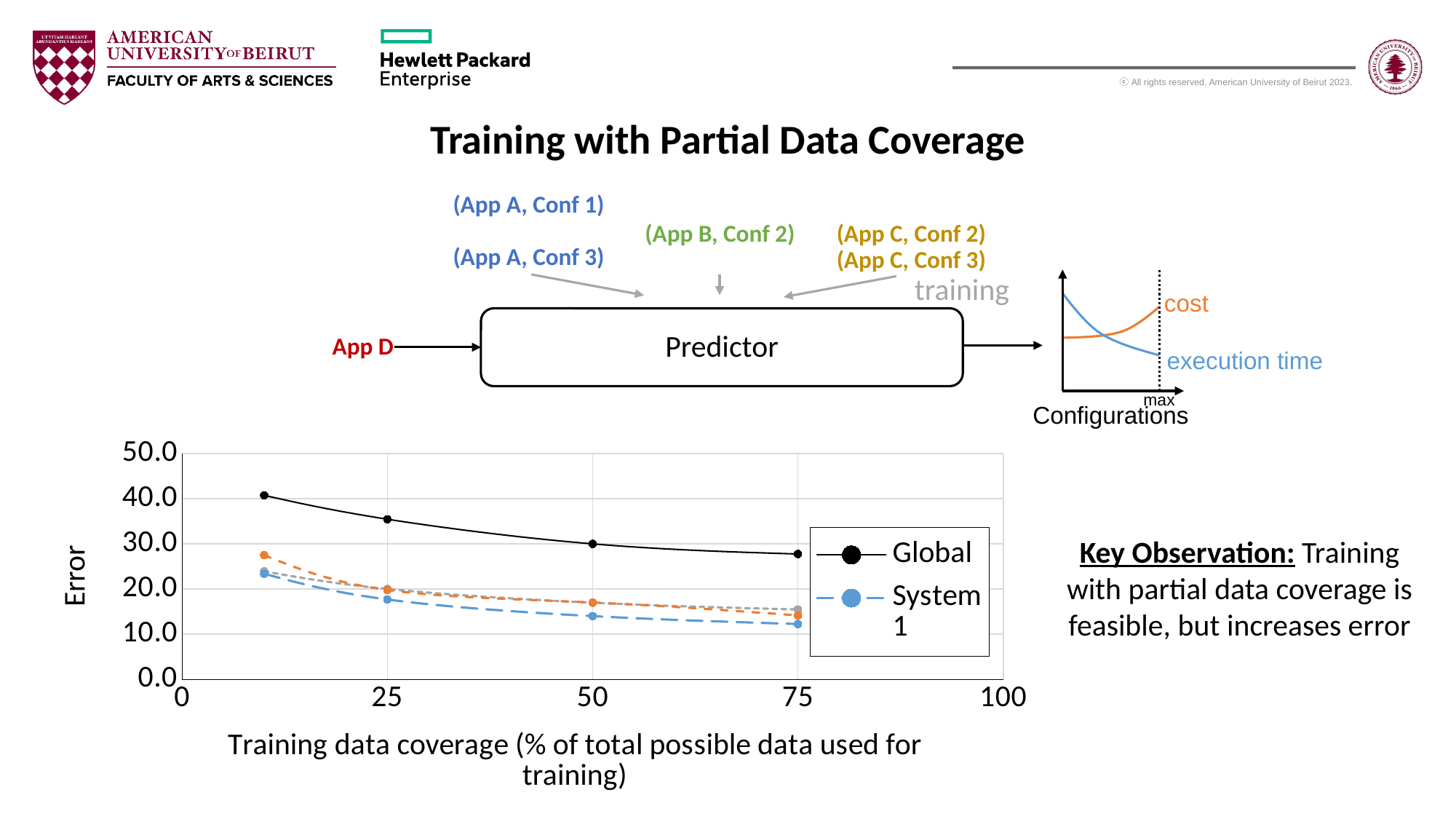
What is the label of the y-axis of the chart? Error Is the Global error at 75% training data coverage greater or less than 30? less What kind of chart is shown at the bottom of the slide? line chart Is the Global error at 25% training data coverage greater or less than 30? greater Is the System 1 error at 10% training data coverage greater or less than 20? greater Does the error for the Global series rise or fall as training data coverage increases? fall Which series has the lowest error at 50% training data coverage? System 1 At 25% training data coverage, which series has the higher error, Global or System 1? Global How many data points does the Global series have? 4 How many series does the chart's legend list? 2 Which series has the highest error at 75% training data coverage? Global